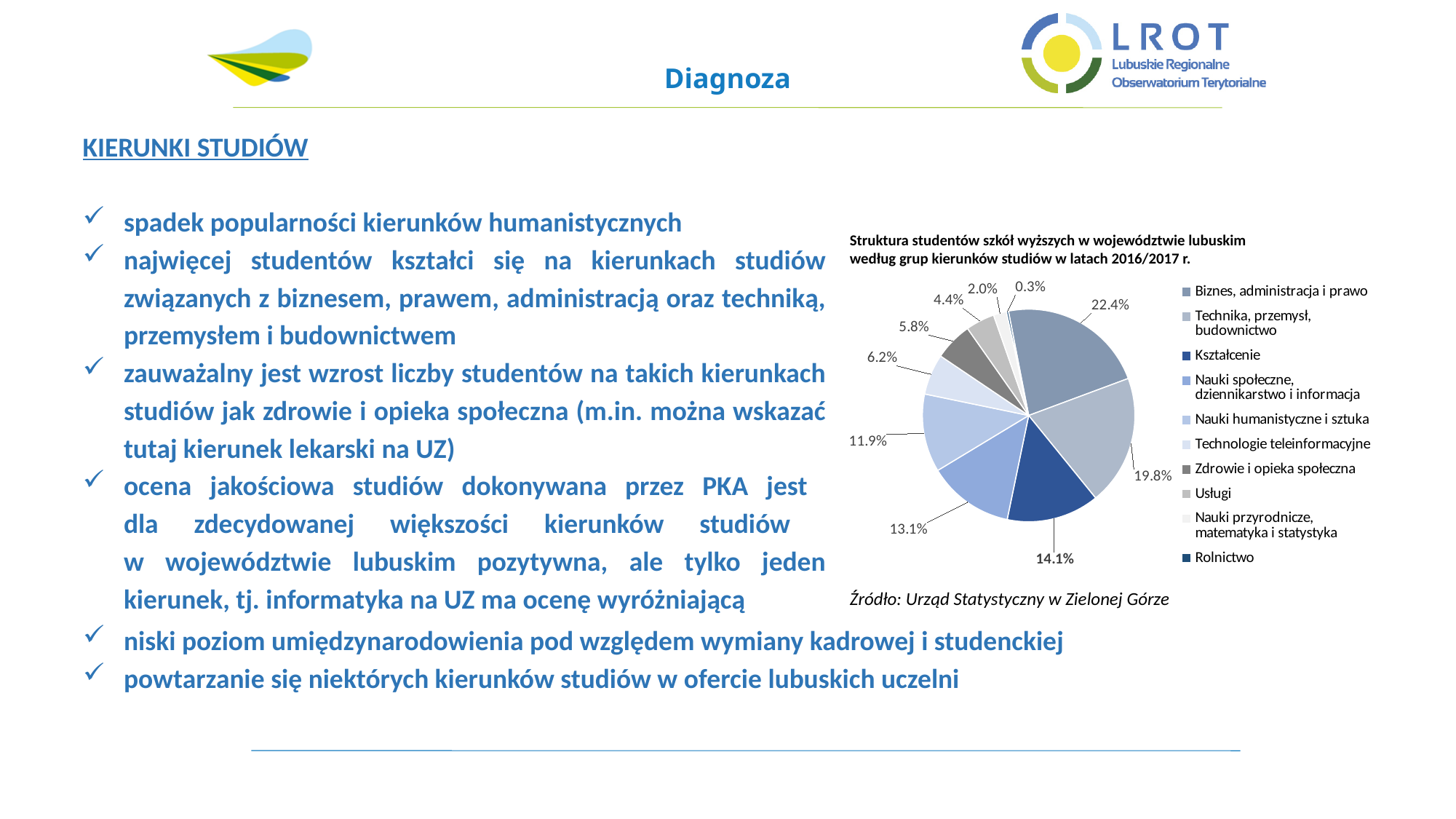
What share of students is in the 'Kształcenie' group? 14.1% What is the difference in percentage points between 'Biznes, administracja i prawo' and 'Technika, przemysł, budownictwo'? 2.6 What source is given for the chart? Urząd Statystyczny w Zielonej Górze Which has a larger share: 'Nauki społeczne, dziennikarstwo i informacja' or 'Technologie teleinformacyjne'? Nauki społeczne, dziennikarstwo i informacja Which group of study fields has the smallest share of students? Rolnictwo How many groups of study fields are shown in the pie chart? 10 What kind of chart is shown on the slide? pie chart What share of students is in the 'Biznes, administracja i prawo' group? 22.4% Which group of study fields has the largest share of students? Biznes, administracja i prawo What share of students is in the 'Zdrowie i opieka społeczna' group? 5.8% What is the title of the pie chart? Struktura studentów szkół wyższych w województwie lubuskim według grup kierunków studiów w latach 2016/2017 r. What share of students is in the 'Nauki humanistyczne i sztuka' group? 11.9%